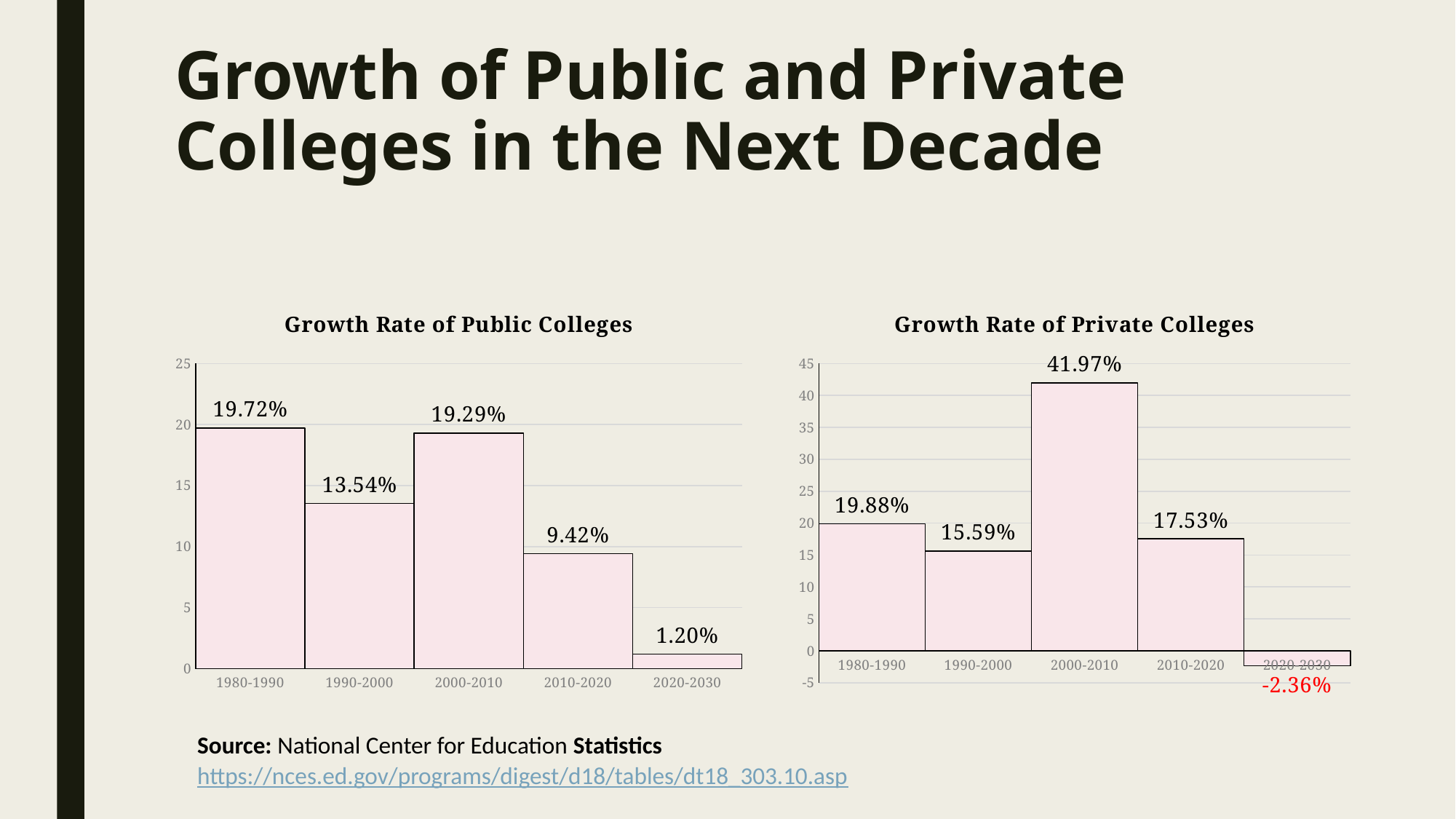
In the 'Growth Rate of Private Colleges' chart, what is the value for 2020-2030? -2.36% In the 'Growth Rate of Private Colleges' chart, which period has the highest value? 2000-2010 In the 'Growth Rate of Private Colleges' chart, which period has the lowest value? 2020-2030 In the 'Growth Rate of Private Colleges' chart, what is the difference between the values for 2000-2010 and 2010-2020? 24.44% In the 'Growth Rate of Public Colleges' chart, what is the value for 1990-2000? 13.54% In the 'Growth Rate of Public Colleges' chart, do the values generally rise or fall from 2000-2010 to 2020-2030? fall How many periods are shown in the 'Growth Rate of Public Colleges' chart? 5 In the 'Growth Rate of Public Colleges' chart, is the value for 2010-2020 greater or less than 10? less In the 'Growth Rate of Public Colleges' chart, what is the difference between the values for 2000-2010 and 2010-2020? 9.87% What kind of chart is the 'Growth Rate of Private Colleges' chart? bar chart In the 'Growth Rate of Private Colleges' chart, which is larger, the value for 1980-1990 or the value for 1990-2000? 1980-1990 In the 'Growth Rate of Public Colleges' chart, which period has the highest value? 1980-1990